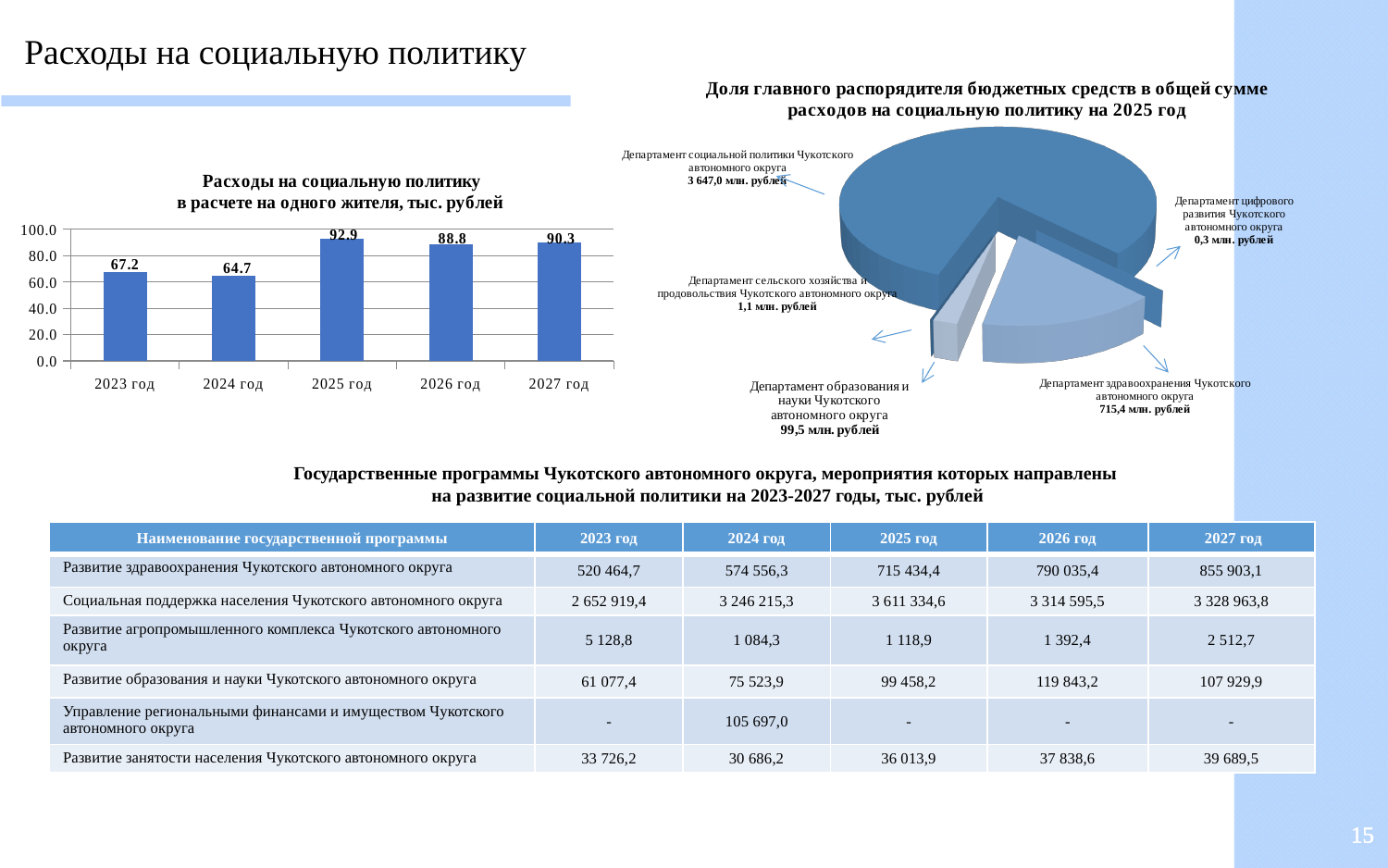
In the bar chart 'Расходы на социальную политику в расчете на одного жителя, тыс. рублей', which year has the lowest value? 2024 год In the pie chart 'Доля главного распорядителя бюджетных средств в общей сумме расходов на социальную политику на 2025 год', what is the value for Департамент здравоохранения Чукотского автономного округа? 715,4 млн. рублей What type of chart is 'Расходы на социальную политику в расчете на одного жителя, тыс. рублей'? bar chart In the pie chart 'Доля главного распорядителя бюджетных средств в общей сумме расходов на социальную политику на 2025 год', which department has the smallest value? Департамент цифрового развития Чукотского автономного округа In the bar chart 'Расходы на социальную политику в расчете на одного жителя, тыс. рублей', which year has the highest value? 2025 год In the bar chart 'Расходы на социальную политику в расчете на одного жителя, тыс. рублей', what is the value for 2026 год? 88.8 In the pie chart 'Доля главного распорядителя бюджетных средств в общей сумме расходов на социальную политику на 2025 год', which department has the largest value? Департамент социальной политики Чукотского автономного округа In the bar chart 'Расходы на социальную политику в расчете на одного жителя, тыс. рублей', what is the difference between the values for 2025 год and 2024 год? 28.2 In the bar chart 'Расходы на социальную политику в расчете на одного жителя, тыс. рублей', what is the value for 2023 год? 67.2 In the bar chart 'Расходы на социальную политику в расчете на одного жителя, тыс. рублей', which is larger: the value for 2027 год or 2026 год? 2027 год How many departments are shown in the pie chart 'Доля главного распорядителя бюджетных средств в общей сумме расходов на социальную политику на 2025 год'? 5 How many years are shown in the bar chart 'Расходы на социальную политику в расчете на одного жителя, тыс. рублей'? 5